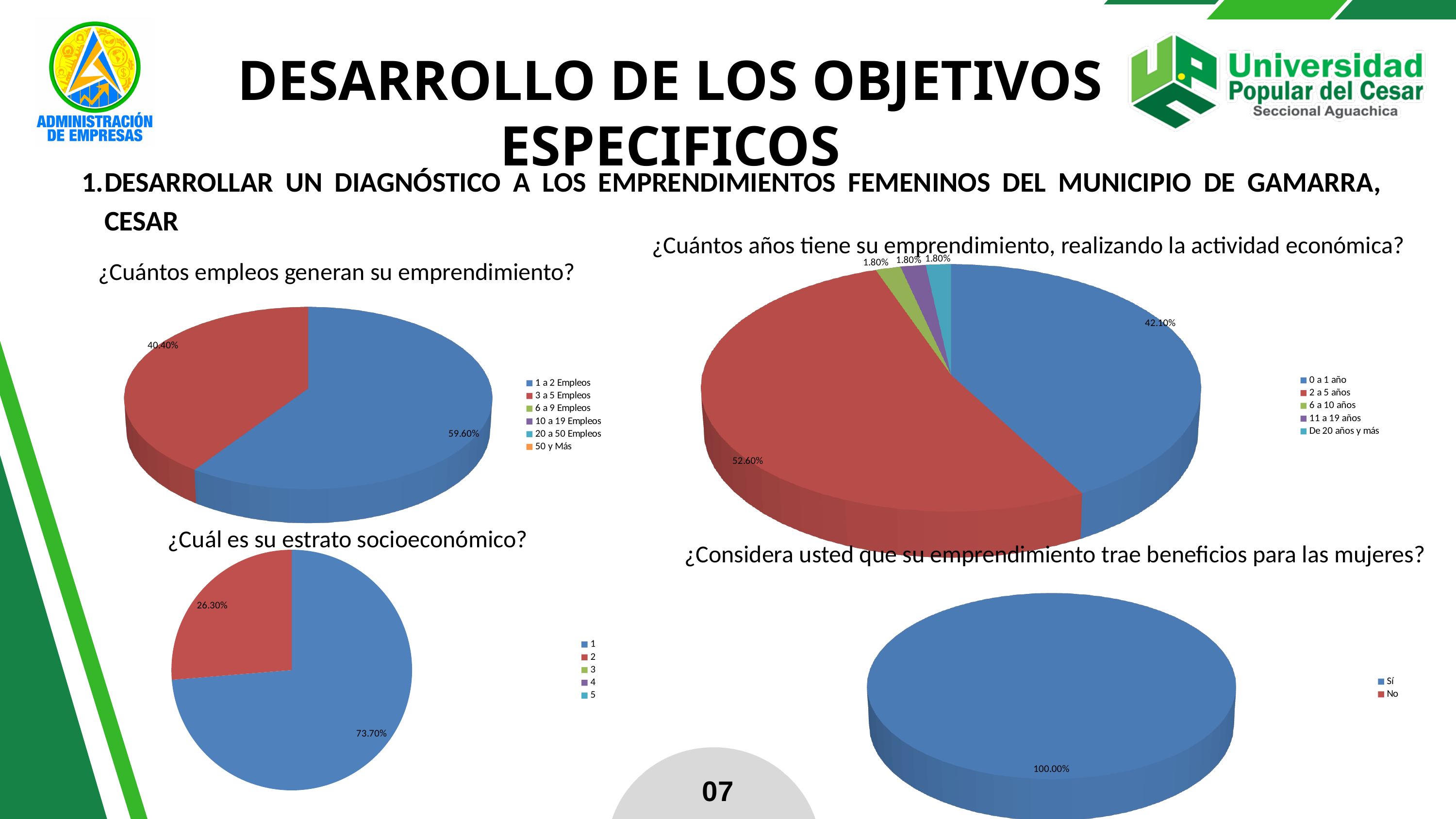
In the chart '¿Cuál es su estrato socioeconómico?', what share is labelled for category '1'? 73.70% In the chart '¿Cuántos años tiene su emprendimiento, realizando la actividad económica?', which category has the largest slice? 2 a 5 años In the chart '¿Cuántos empleos generan su emprendimiento?', what share is labelled for '1 a 2 Empleos'? 59.60% In the chart '¿Cuál es su estrato socioeconómico?', which is larger, the slice for '1' or the slice for '2'? 1 In the chart '¿Cuántos años tiene su emprendimiento, realizando la actividad económica?', how many entries does the legend list? 5 What kind of chart is '¿Considera usted que su emprendimiento trae beneficios para las mujeres?'? Pie chart In the chart '¿Cuántos empleos generan su emprendimiento?', what share is labelled for '3 a 5 Empleos'? 40.40% In the chart '¿Considera usted que su emprendimiento trae beneficios para las mujeres?', what share is labelled for 'Sí'? 100.00% In the chart '¿Cuántos empleos generan su emprendimiento?', what is the difference between the '1 a 2 Empleos' and '3 a 5 Empleos' shares? 19.20% In the chart '¿Cuántos años tiene su emprendimiento, realizando la actividad económica?', what share is labelled for '0 a 1 año'? 42.10% In the chart '¿Cuántos años tiene su emprendimiento, realizando la actividad económica?', what share is labelled for '2 a 5 años'? 52.60% In the chart '¿Cuántos empleos generan su emprendimiento?', how many entries does the legend list? 6